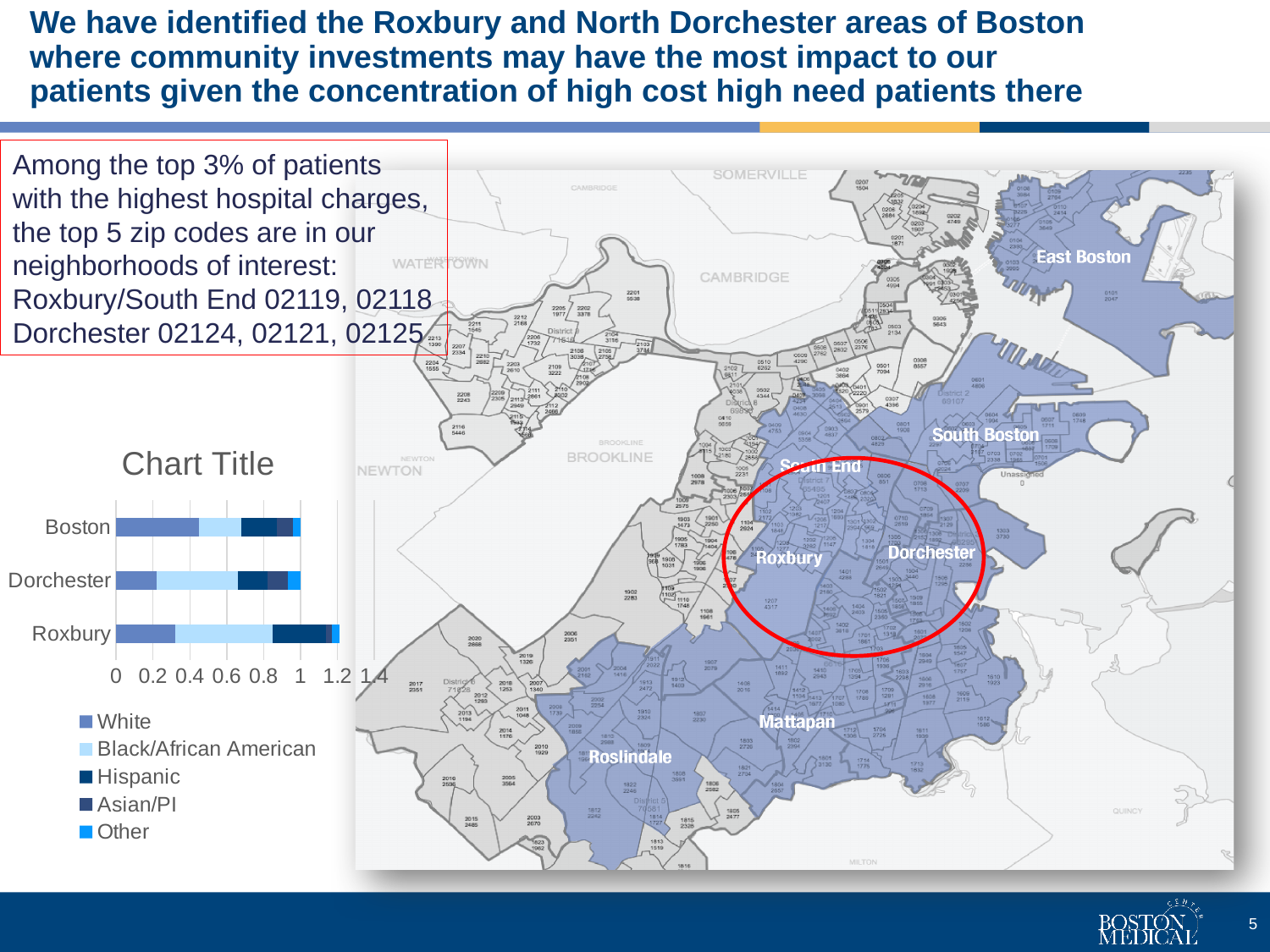
Which series is listed first in the chart's legend? White How many categories are shown on the chart's vertical axis? 3 Which category has the longest stacked bar in the chart? Roxbury Is the total stacked bar length for Boston greater or less than 0.6? greater Is the total stacked bar length for Roxbury greater or less than 0.8? greater What kind of chart is shown on the slide? bar chart How many series does the chart's legend list? 5 Is the total stacked bar length for Dorchester greater or less than 1.2? less What is the title of the chart? Chart Title What is the highest value shown on the chart's horizontal axis? 1.4